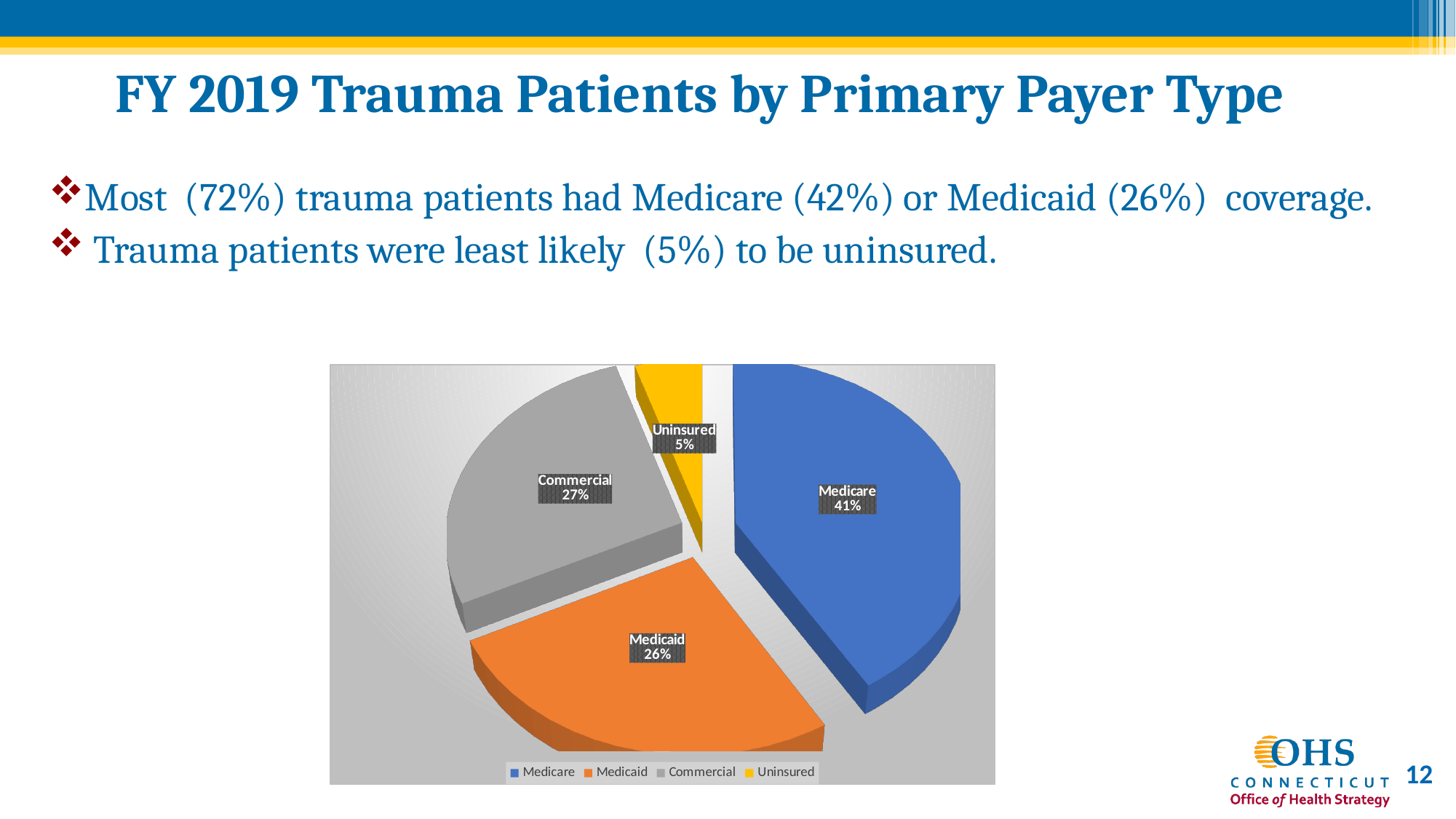
Which payer type has the largest slice of the pie chart? Medicare What percentage is shown for the Uninsured slice? 5% Which payer type has the smallest slice of the pie chart? Uninsured How many entries does the chart legend list? 4 What percentage of trauma patients had Medicare as their primary payer according to the pie chart? 41% What colour is the Medicaid slice in the pie chart? Orange What kind of chart is shown on the slide? Pie chart What share of the pie chart is labelled Medicaid? 26% What percentage is shown for the Commercial slice? 27% What is the difference in percentage points between the Medicare slice and the Medicaid slice? 15 Which slice is larger, Commercial or Medicaid? Commercial How many payer types are shown in the pie chart? 4